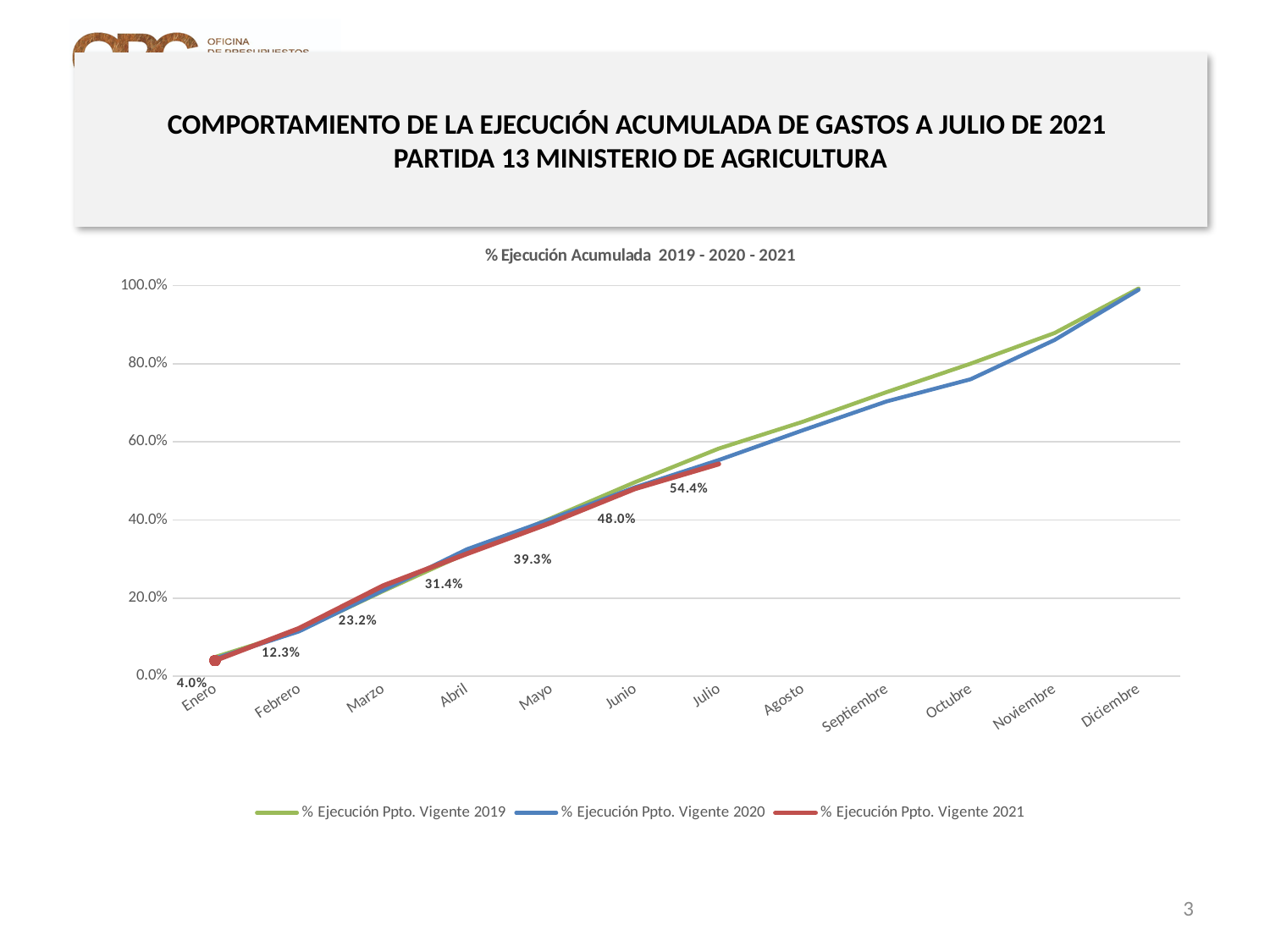
Is the value of % Ejecución Ppto. Vigente 2020 for Octubre greater or less than 80.0%? less What is the difference between the 2021 values for Febrero and Enero? 8.3% How many series does the legend list? 3 What is the value of % Ejecución Ppto. Vigente 2021 for Marzo? 23.2% How many months are shown on the x axis? 12 What is the title of the chart? % Ejecución Acumulada 2019 - 2020 - 2021 Do the values of the 2021 series rise or fall from Enero to Julio? rise What is the value of % Ejecución Ppto. Vigente 2021 for Julio? 54.4% What kind of chart is shown on the slide? line chart What is the difference between the 2021 values for Julio and Junio? 6.4% What is the value of % Ejecución Ppto. Vigente 2021 for Abril? 31.4% What is the value of % Ejecución Ppto. Vigente 2021 for Enero? 4.0%